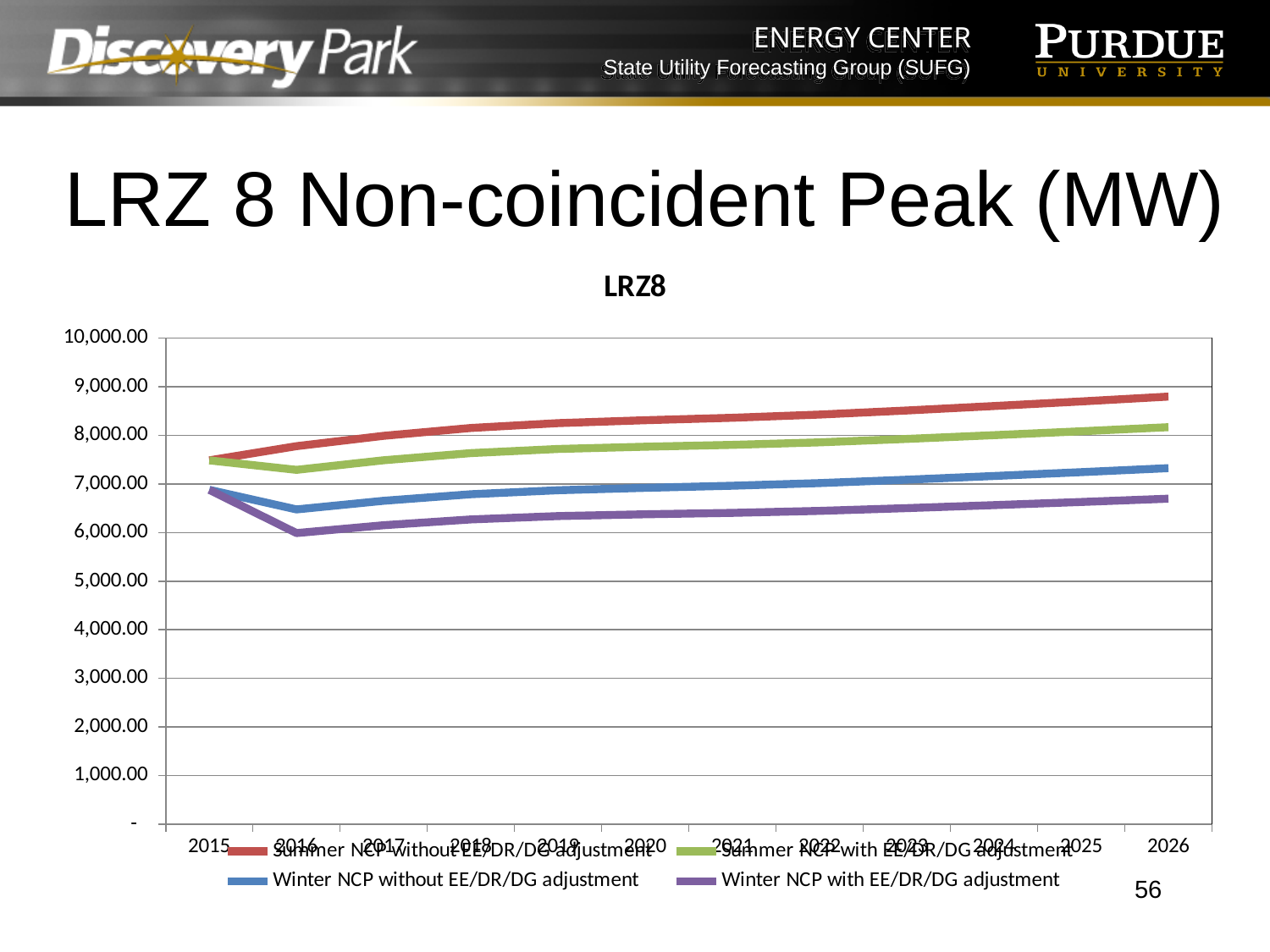
What is the title shown above the chart? LRZ8 Is the value for Summer NCP without EE/DR/DG adjustment in 2015 greater or less than 8,000? less Does the Summer NCP without EE/DR/DG adjustment series rise or fall from 2016 to 2026? rise How many series does the legend list? 4 Which series is drawn in red? Summer NCP without EE/DR/DG adjustment Which series has the lowest value in 2026? Winter NCP with EE/DR/DG adjustment What kind of chart is shown on the slide? Line chart How many years are plotted along the x axis? 12 Is the value for Winter NCP with EE/DR/DG adjustment in 2016 greater or less than 7,000? less In 2026, which is larger: Summer NCP without EE/DR/DG adjustment or Summer NCP with EE/DR/DG adjustment? Summer NCP without EE/DR/DG adjustment Which series has the highest value in 2026? Summer NCP without EE/DR/DG adjustment Is the value for Summer NCP without EE/DR/DG adjustment in 2026 greater or less than 8,000? greater